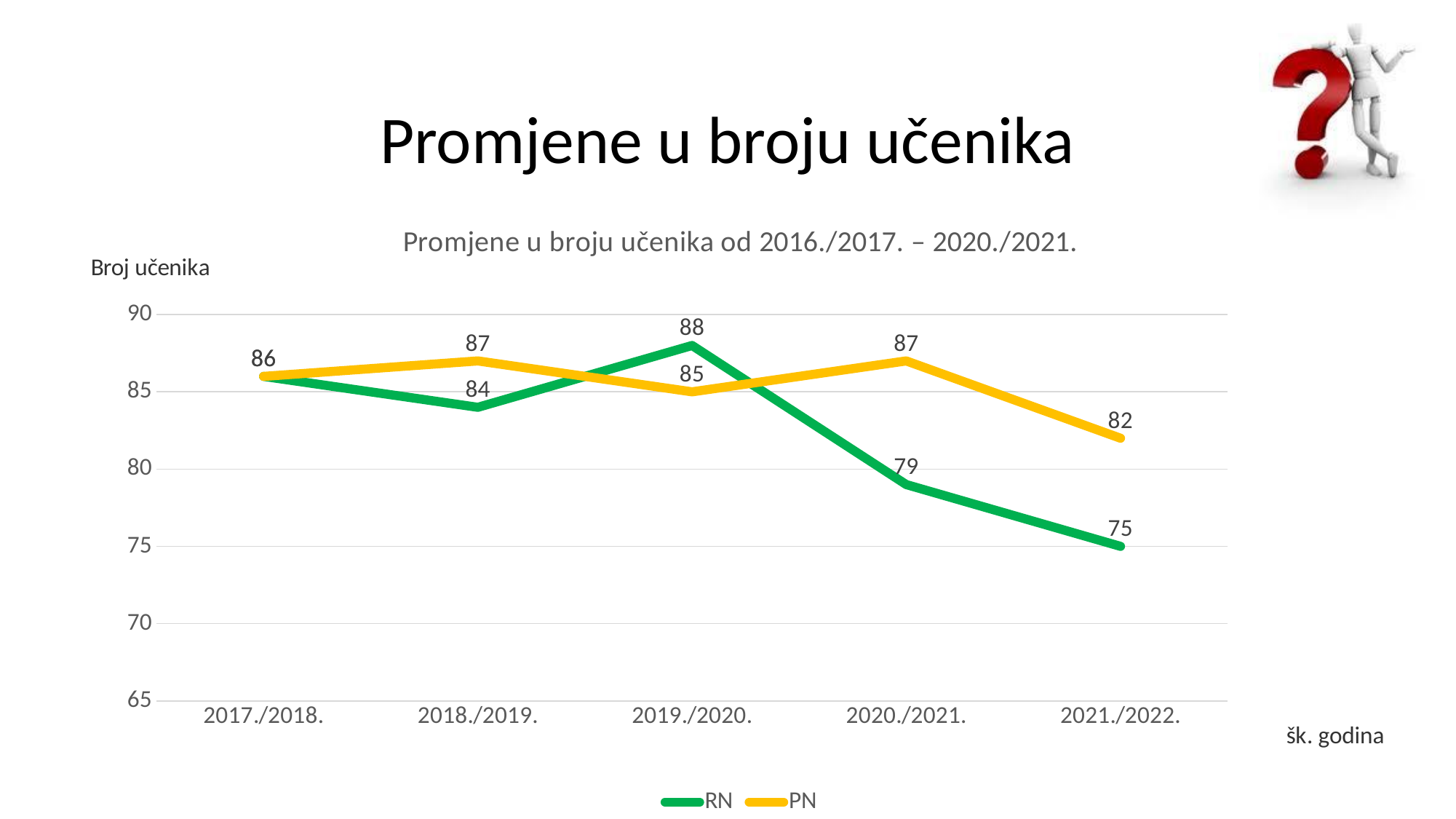
In which school year does the RN series have its lowest value? 2021./2022. Does the RN series rise or fall from 2019./2020. to 2021./2022.? fall What kind of chart is shown on the slide? line chart In which school year does the RN series reach its highest value? 2019./2020. In 2020./2021., which series has the larger value, RN or PN? PN What is the value for RN in 2021./2022.? 75 What is the value for PN in 2018./2019.? 87 What is the difference between PN and RN in 2021./2022.? 7 What is the value for PN in 2021./2022.? 82 How many school years are shown on the x axis? 5 What is the value for RN in 2019./2020.? 88 How many series does the legend list? 2